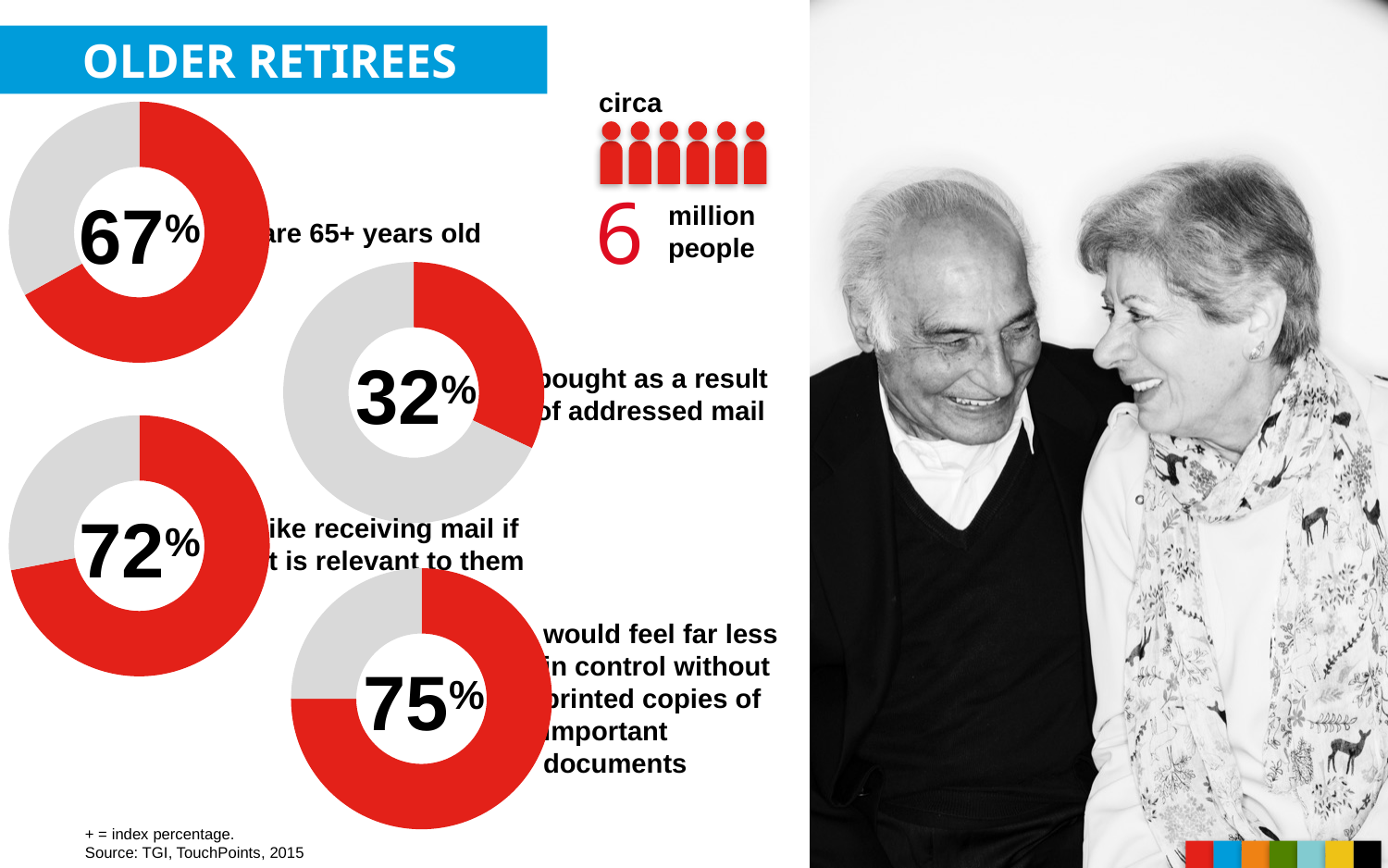
What percentage of older retirees are 65+ years old, according to the top-left donut chart? 67% What type of chart is used to display the percentages on the slide? Donut (pie) chart How many donut charts are shown on the slide? 4 What colour is used for the filled (percentage) portion of each donut chart? Red Which of the four donut charts shows the highest percentage? would feel far less in control without printed copies of important documents (75%) Which is larger: the percentage who are 65+ years old or the percentage who like receiving mail if it is relevant to them? like receiving mail if it is relevant to them (72%) What is the difference between the highest and lowest percentages shown in the donut charts? 43% What percentage of older retirees bought as a result of addressed mail? 32% What percentage of older retirees like receiving mail if it is relevant to them? 72% What percentage of older retirees would feel far less in control without printed copies of important documents? 75% What is the difference between the percentage who like receiving relevant mail and the percentage who bought as a result of addressed mail? 40% Which of the four donut charts shows the lowest percentage? bought as a result of addressed mail (32%)